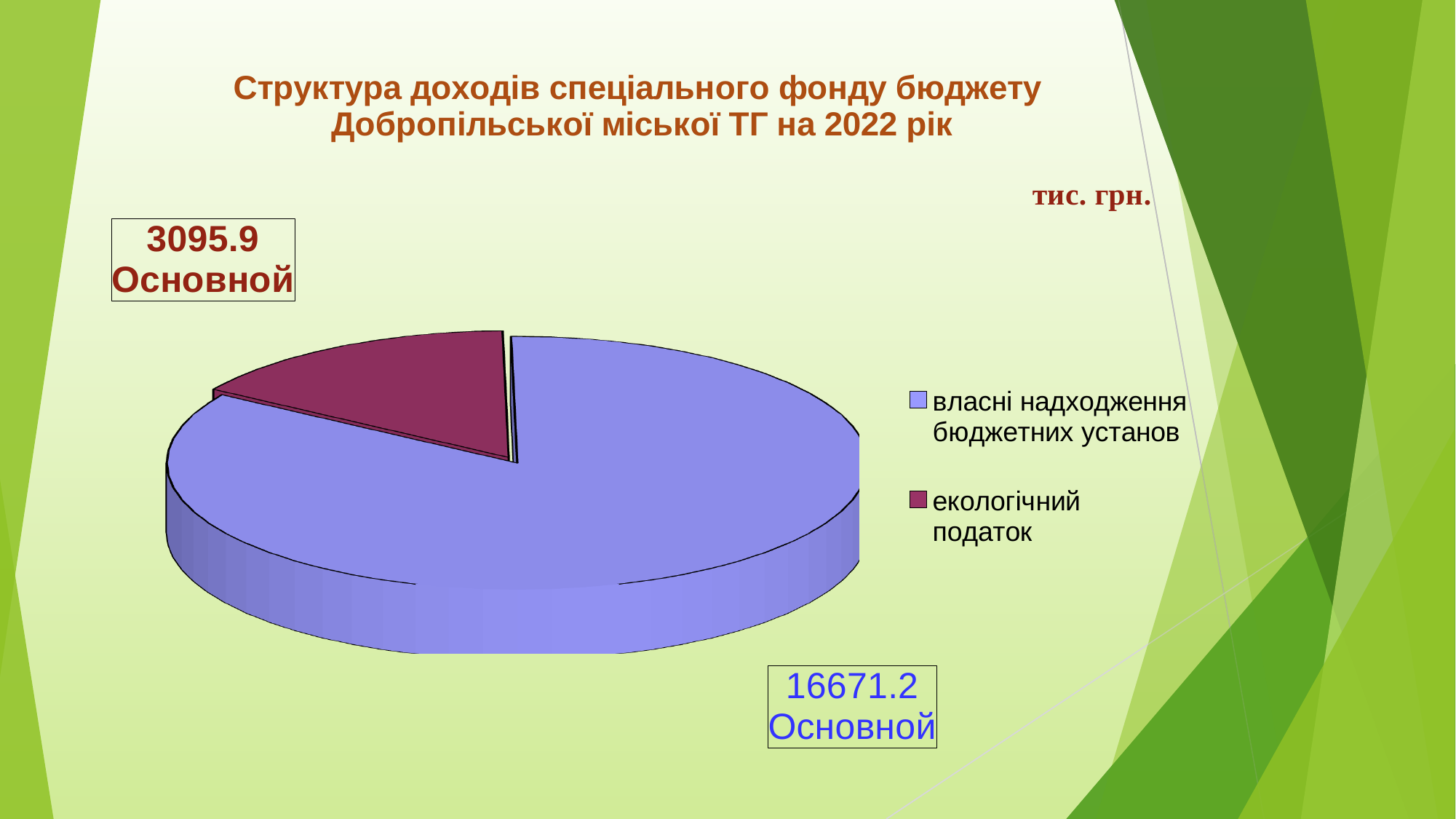
What is the total of the two values shown in the pie chart? 19767.1 How many entries does the legend list? 2 What is the difference between the value for власні надходження бюджетних установ and the value for екологічний податок? 13575.3 Which category has the smallest slice of the pie? екологічний податок Which category has the largest slice of the pie? власні надходження бюджетних установ What colour is the slice for екологічний податок? Dark red What unit of measurement is indicated on the slide for the chart values? тис. грн. Which is larger: власні надходження бюджетних установ or екологічний податок? власні надходження бюджетних установ What is the value for власні надходження бюджетних установ? 16671.2 How many slices does the pie chart have? 2 What is the value for екологічний податок? 3095.9 What type of chart is shown on the slide? Pie chart